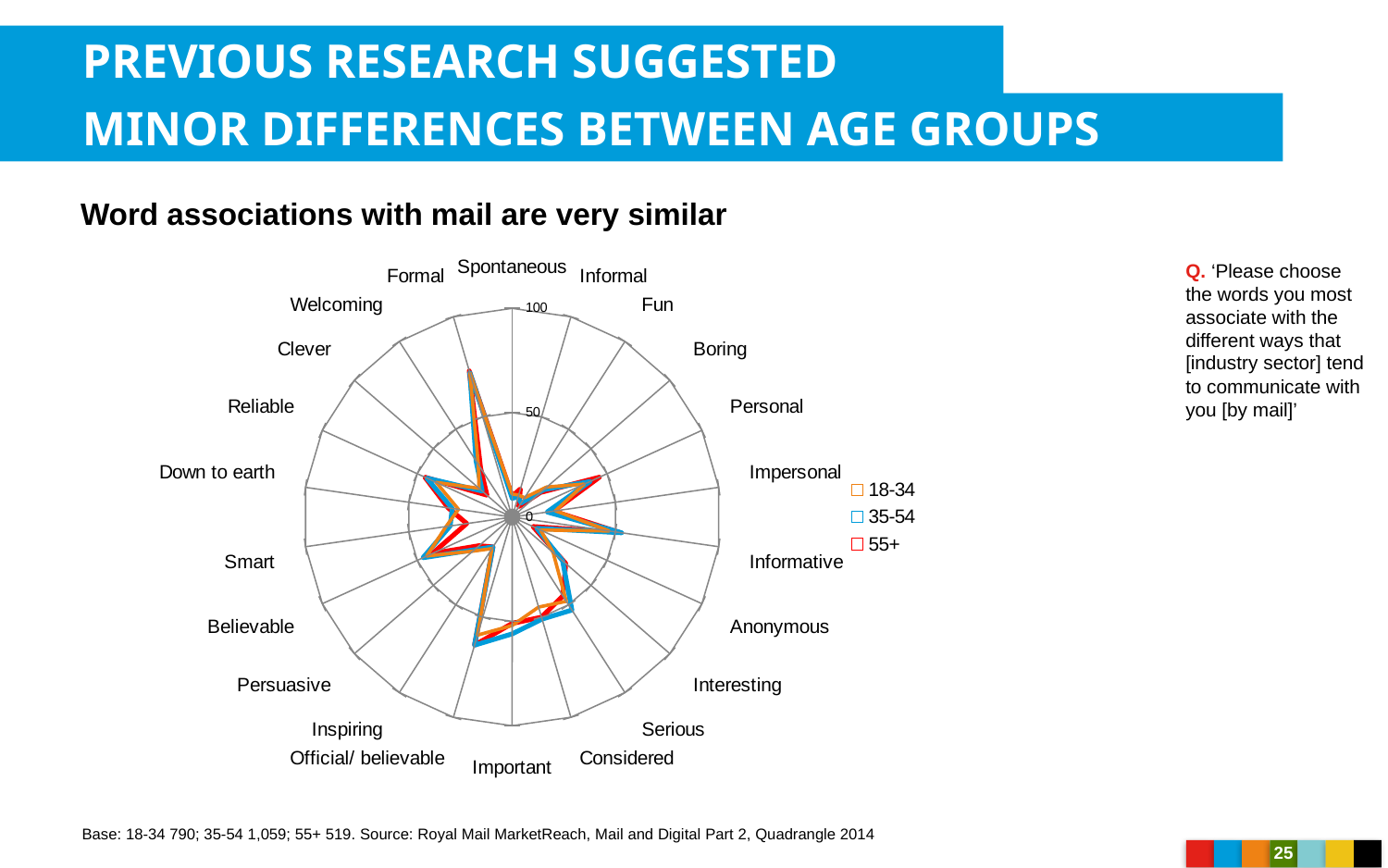
Is the value for Spontaneous greater or less than 50? less How many series does the chart's legend list? 3 Which age groups are listed in the chart's legend? 18-34, 35-54, 55+ Which word has the highest values across the age groups on the chart? Formal Is the value for Persuasive greater or less than 50? less What is the maximum value shown on the chart's axis scale? 100 What kind of chart is shown on the slide? Radar chart How many word categories are plotted around the radar chart? 22 Which is larger on the chart, the value for Spontaneous or the value for Formal? Formal Is the value for Formal greater or less than 50? greater Which is larger on the chart, the value for Spontaneous or the value for Clever? Clever